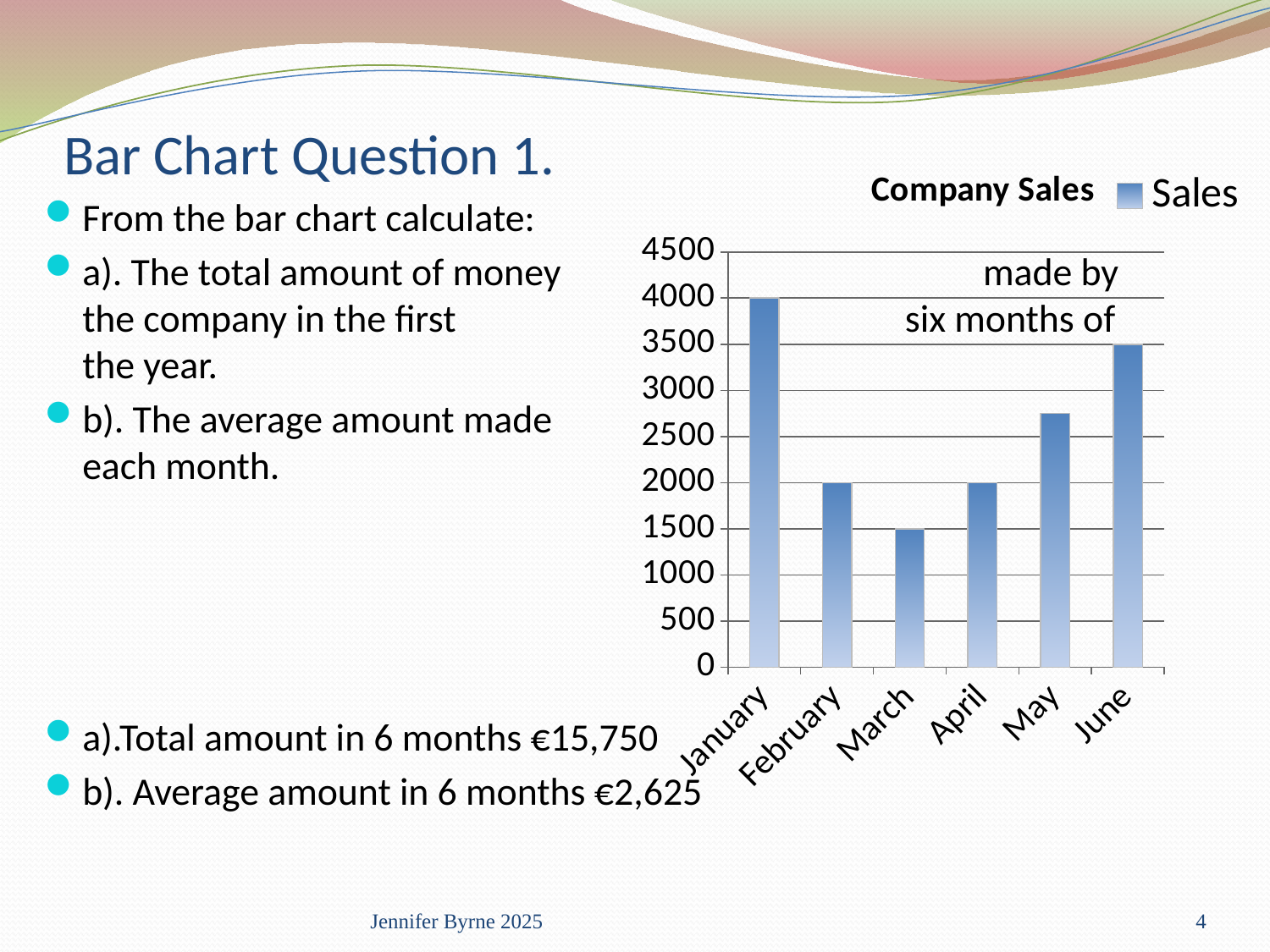
How many months are shown on the x axis of the chart? 6 Is the sales value for May greater or less than 2500? greater Which month has the highest sales? January What is the sales value for June? 3500 Which month has higher sales, June or February? June Which month has the lowest sales? March What is the sales value for January? 4000 How many series does the chart legend list? 1 What is the sales value for March? 1500 What is the title of the chart? Company Sales What type of chart is shown on the slide? bar chart What is the difference between the sales for January and the sales for March? 2500